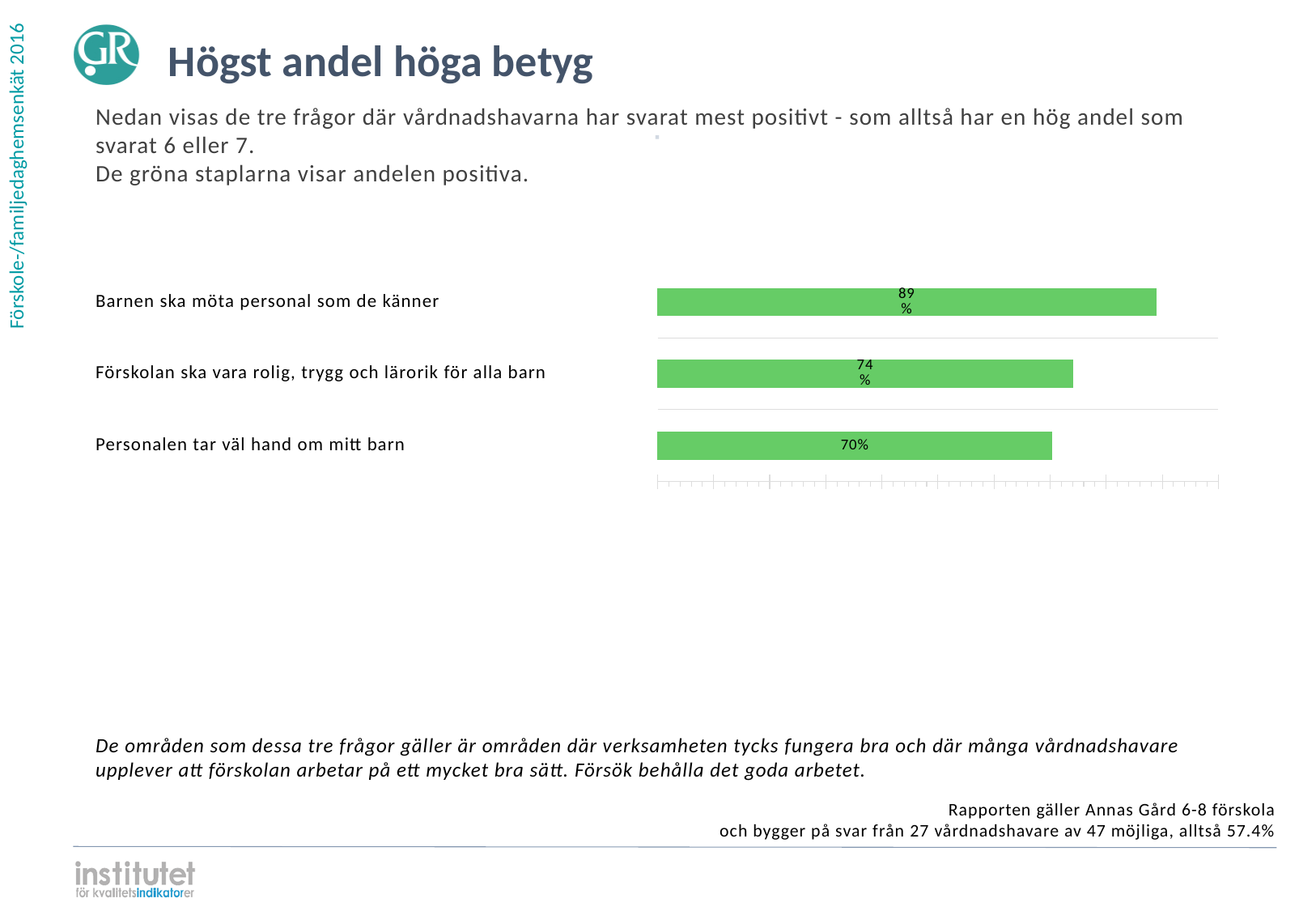
What value is shown for "Förskolan ska vara rolig, trygg och lärorik för alla barn"? 74% Which category has the highest value? Barnen ska möta personal som de känner How many categories are shown in the chart? 3 What value is shown for "Barnen ska möta personal som de känner"? 89% Which is larger: the value for "Barnen ska möta personal som de känner" or for "Förskolan ska vara rolig, trygg och lärorik för alla barn"? Barnen ska möta personal som de känner What value is shown for "Personalen tar väl hand om mitt barn"? 70% What is the title of the slide containing the chart? Högst andel höga betyg What is the difference between the values for "Barnen ska möta personal som de känner" and "Personalen tar väl hand om mitt barn"? 19 percentage points What colour are the bars in the chart? Green Which category has the lowest value? Personalen tar väl hand om mitt barn What kind of chart is shown on the slide? Bar chart What is the difference between the values for "Förskolan ska vara rolig, trygg och lärorik för alla barn" and "Personalen tar väl hand om mitt barn"? 4 percentage points